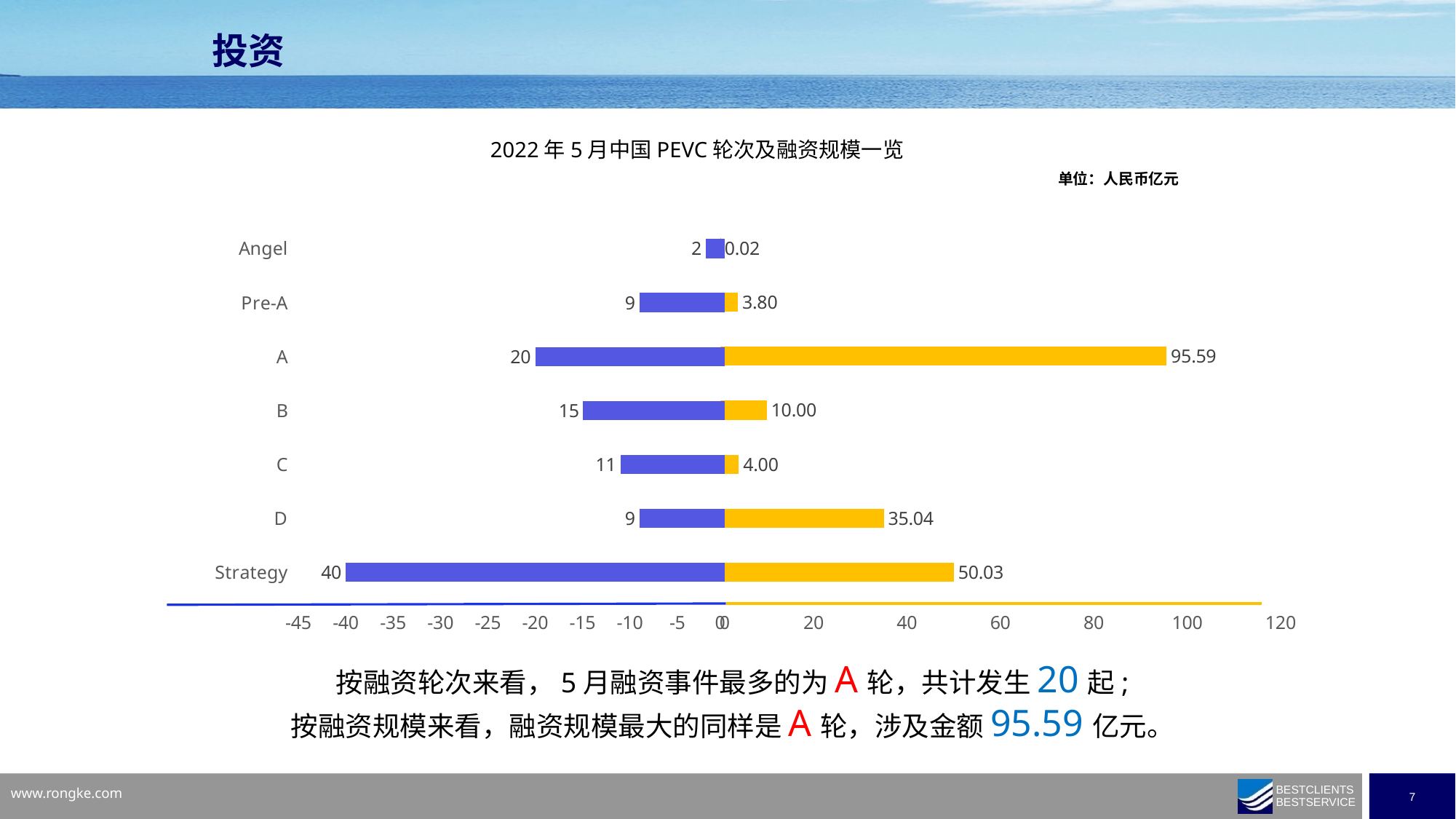
Which has the larger financing amount, the B round or the D round? D What is the financing amount (yellow bar) for the D round? 35.04 What is the number of financing events (blue bar) for the Strategy round? 40 What is the number of financing events (blue bar) for the B round? 15 Which round has the largest financing amount (yellow bar)? A How many rounds (categories) are shown in the chart? 7 Which round has the most financing events (blue bar)? Strategy Which round has the smallest financing amount (yellow bar)? Angel What is the financing amount (yellow bar) for the A round? 95.59 What type of chart is shown on the slide? Bar chart What unit is stated for the financing amounts in the chart? 人民币亿元 What is the difference in financing amount between the A round and the Strategy round? 45.56